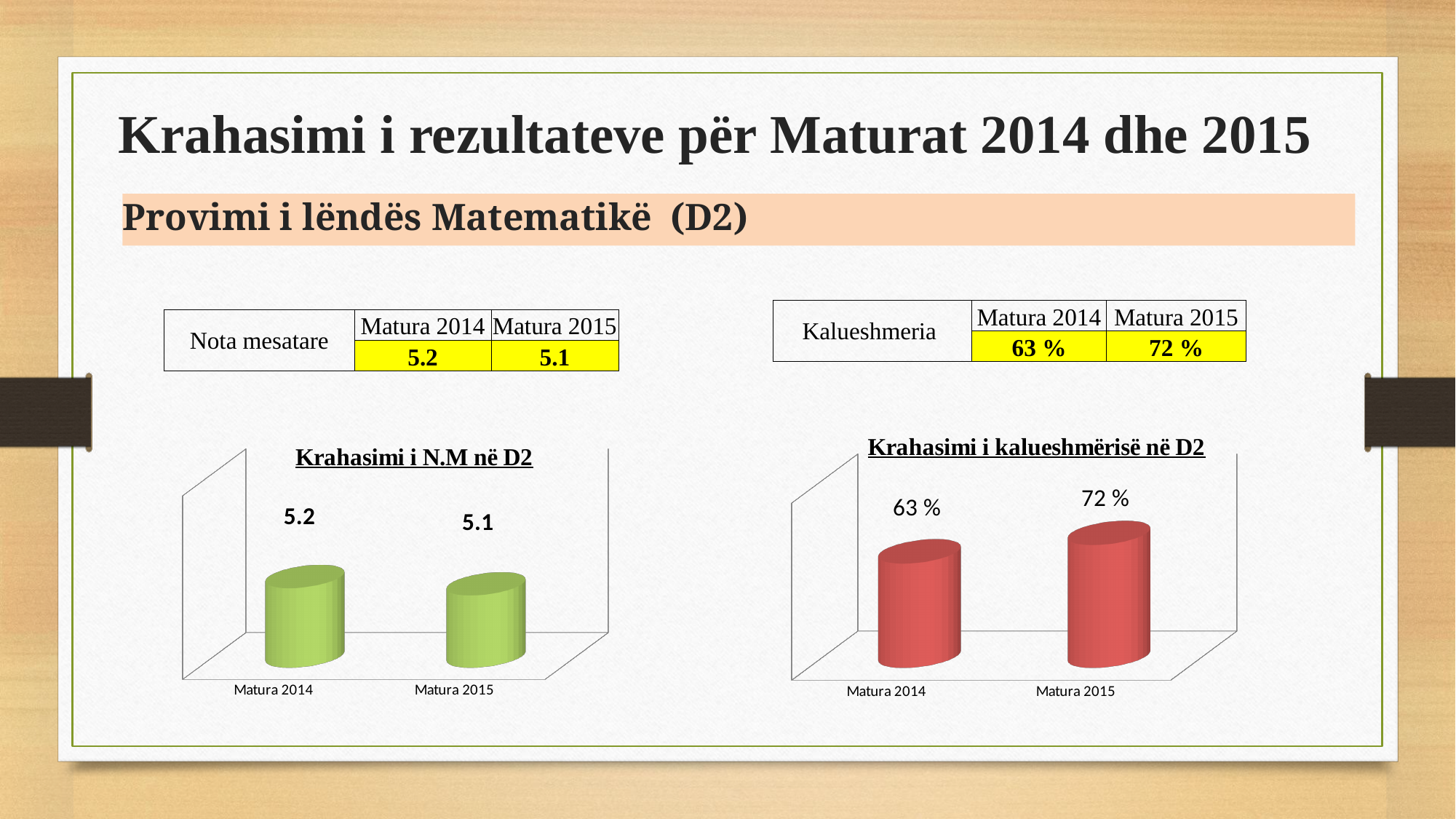
In the chart titled 'Krahasimi i N.M në D2', what is the value for Matura 2015? 5.1 In the chart titled 'Krahasimi i kalueshmërisë në D2', what is the difference between the Matura 2015 and Matura 2014 values? 9 % What kind of chart is the chart titled 'Krahasimi i kalueshmërisë në D2'? bar chart In the chart titled 'Krahasimi i kalueshmërisë në D2', what is the value for Matura 2015? 72 % In the chart titled 'Krahasimi i N.M në D2', what is the value for Matura 2014? 5.2 In the chart titled 'Krahasimi i kalueshmërisë në D2', what is the value for Matura 2014? 63 % In the chart titled 'Krahasimi i kalueshmërisë në D2', which category has the lower value? Matura 2014 In the chart titled 'Krahasimi i N.M në D2', what is the difference between the Matura 2014 and Matura 2015 values? 0.1 In the chart titled 'Krahasimi i N.M në D2', which category has the higher value? Matura 2014 How many categories are shown in the chart titled 'Krahasimi i N.M në D2'? 2 In the chart titled 'Krahasimi i kalueshmërisë në D2', is the value for Matura 2015 larger or smaller than the value for Matura 2014? larger In the chart titled 'Krahasimi i N.M në D2', do the values rise or fall from Matura 2014 to Matura 2015? fall